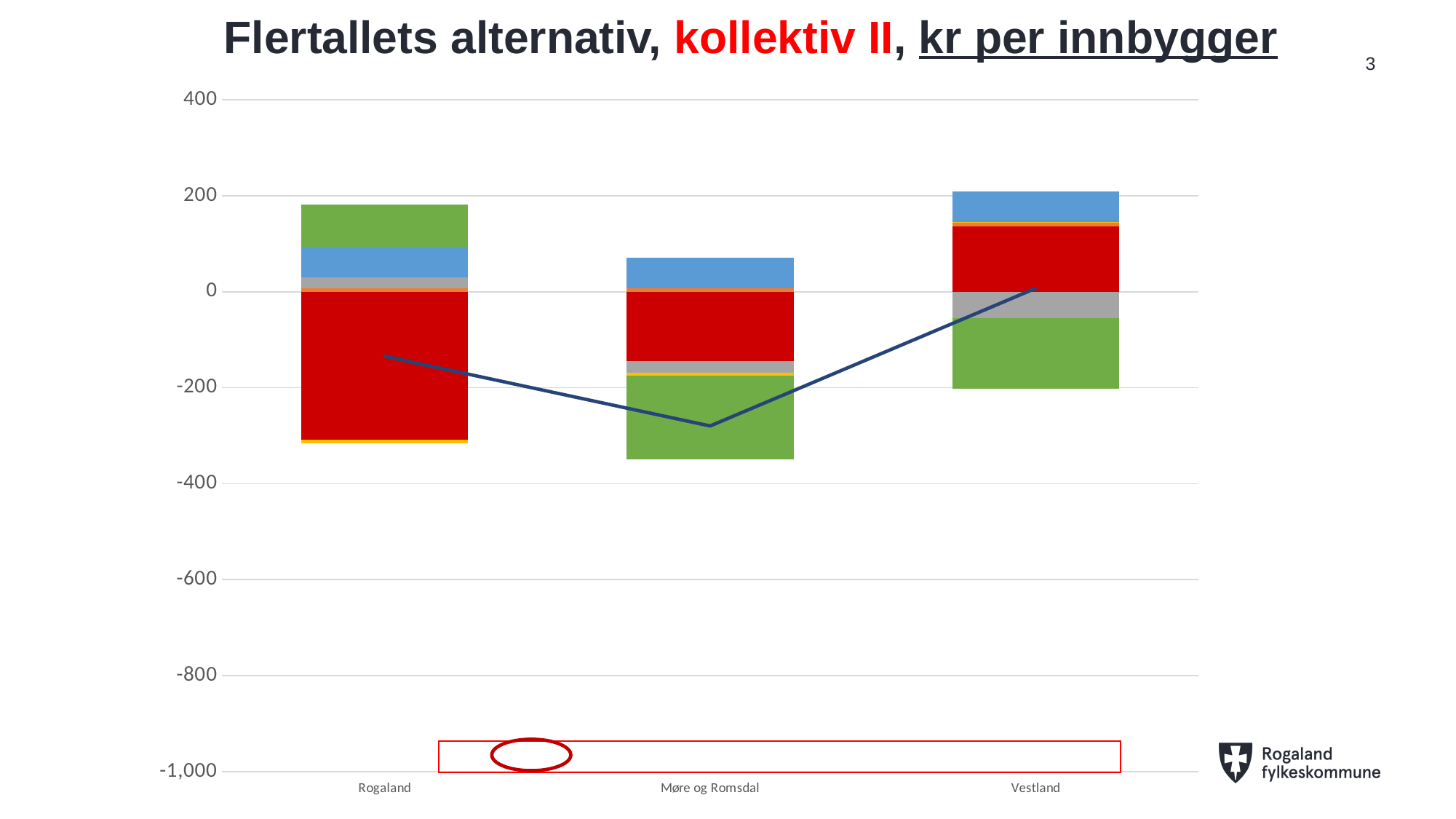
What is the title of the chart on the slide? Flertallets alternativ, kollektiv II, kr per innbygger Is the line value for Møre og Romsdal greater or less than -200? less Which category is the middle one on the x axis? Møre og Romsdal Does the line rise or fall from Rogaland to Møre og Romsdal? fall At which category does the line reach its lowest point? Møre og Romsdal Is the line value for Rogaland greater or less than -200? greater Which stacked bar reaches higher at the top, Rogaland or Vestland? Vestland How many categories are shown on the x axis? 3 Is the bottom of the stacked bar for Møre og Romsdal greater or less than -200? less What kind of chart is shown on the slide? Stacked bar chart with a line At which category does the line reach its highest point? Vestland